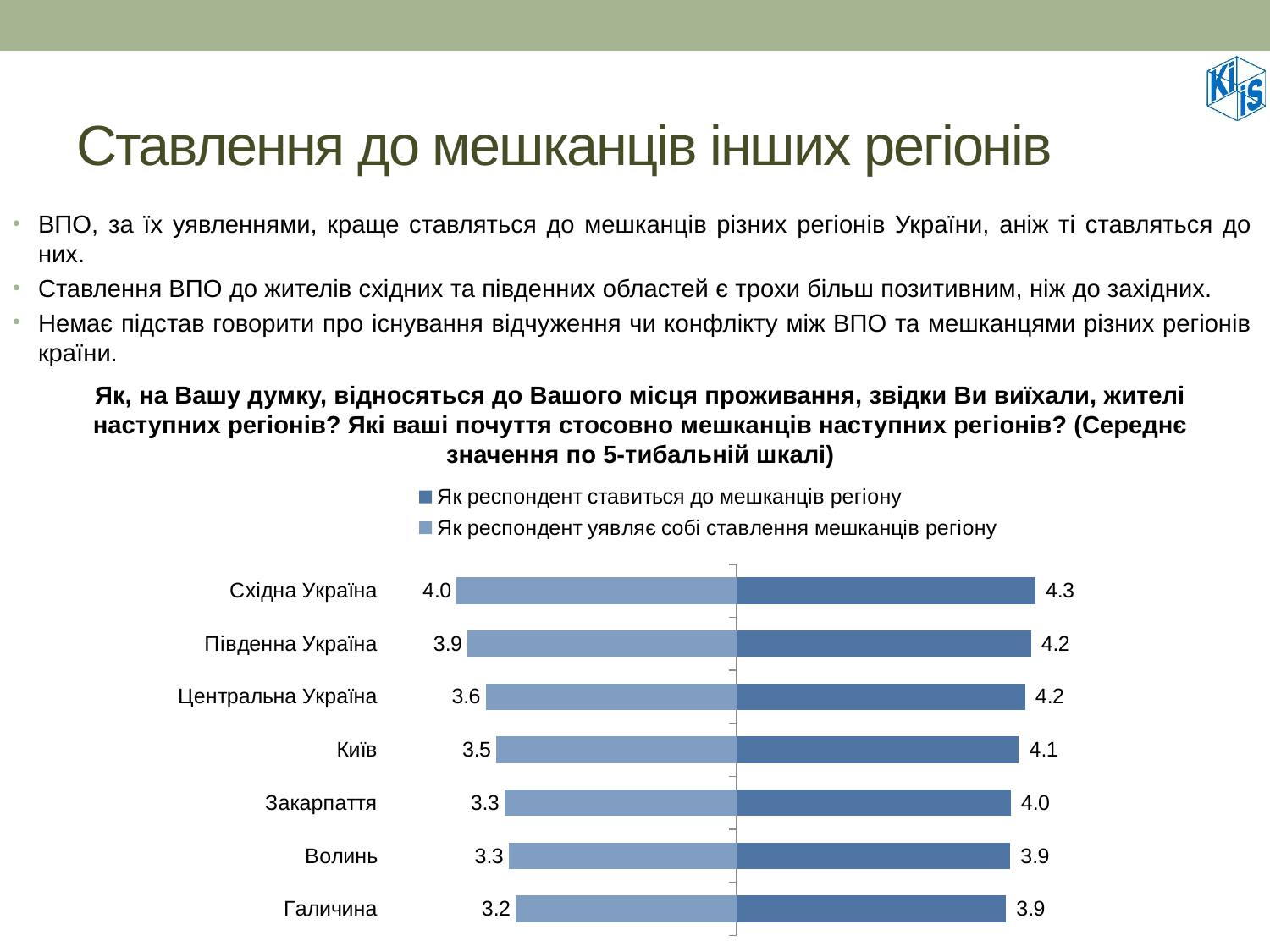
For Закарпаття, which series has the larger value: 'Як респондент ставиться до мешканців регіону' or 'Як респондент уявляє собі ставлення мешканців регіону'? Як респондент ставиться до мешканців регіону What is the difference between the two series values for Центральна Україна? 0.6 Do the values in the series 'Як респондент ставиться до мешканців регіону' rise or fall going down the list from Східна Україна to Галичина? fall How many regions (categories) are shown in the chart? 7 What is the value for Східна Україна in the series 'Як респондент ставиться до мешканців регіону'? 4.3 What is the value for Галичина in the series 'Як респондент уявляє собі ставлення мешканців регіону'? 3.2 How many series does the chart legend list? 2 What is the value for Київ in the series 'Як респондент уявляє собі ставлення мешканців регіону'? 3.5 Which region has the highest value in the series 'Як респондент ставиться до мешканців регіону'? Східна Україна What type of chart is shown on the slide? bar chart Which region has the lowest value in the series 'Як респондент уявляє собі ставлення мешканців регіону'? Галичина What is the value for Волинь in the series 'Як респондент ставиться до мешканців регіону'? 3.9